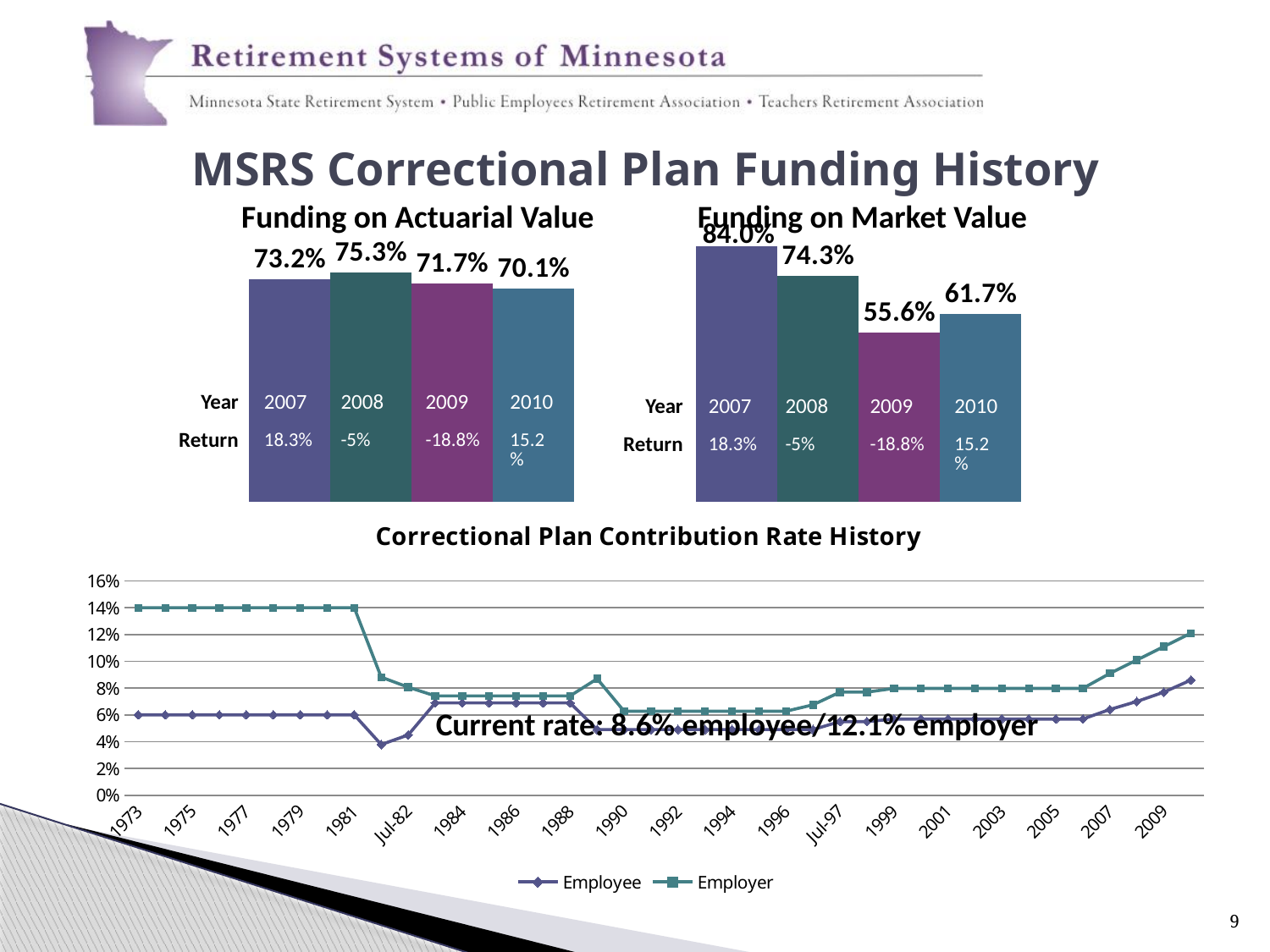
In the Funding on Market Value chart, what is the funding value for 2009? 55.6% How many years are shown in the Funding on Actuarial Value chart? 4 In the Correctional Plan Contribution Rate History chart, do the Employee and Employer rates rise or fall between 2005 and 2009? Rise In the Funding on Actuarial Value chart, which year has the lowest funding value? 2010 In the Funding on Actuarial Value chart, what is the funding value for 2008? 75.3% In the Funding on Actuarial Value chart, what is the difference between the 2008 and 2010 values? 5.2% In the Funding on Market Value chart, what is the difference between the 2007 and 2008 values? 9.7% In the Funding on Market Value chart, which is larger, the value for 2009 or the value for 2010? 2010 How many series does the legend of the Correctional Plan Contribution Rate History chart list? 2 What kind of chart is the Correctional Plan Contribution Rate History chart? Line chart In the Correctional Plan Contribution Rate History chart, is the Employer rate in 1975 greater or less than 12%? greater In the Funding on Market Value chart, which year has the highest funding value? 2007